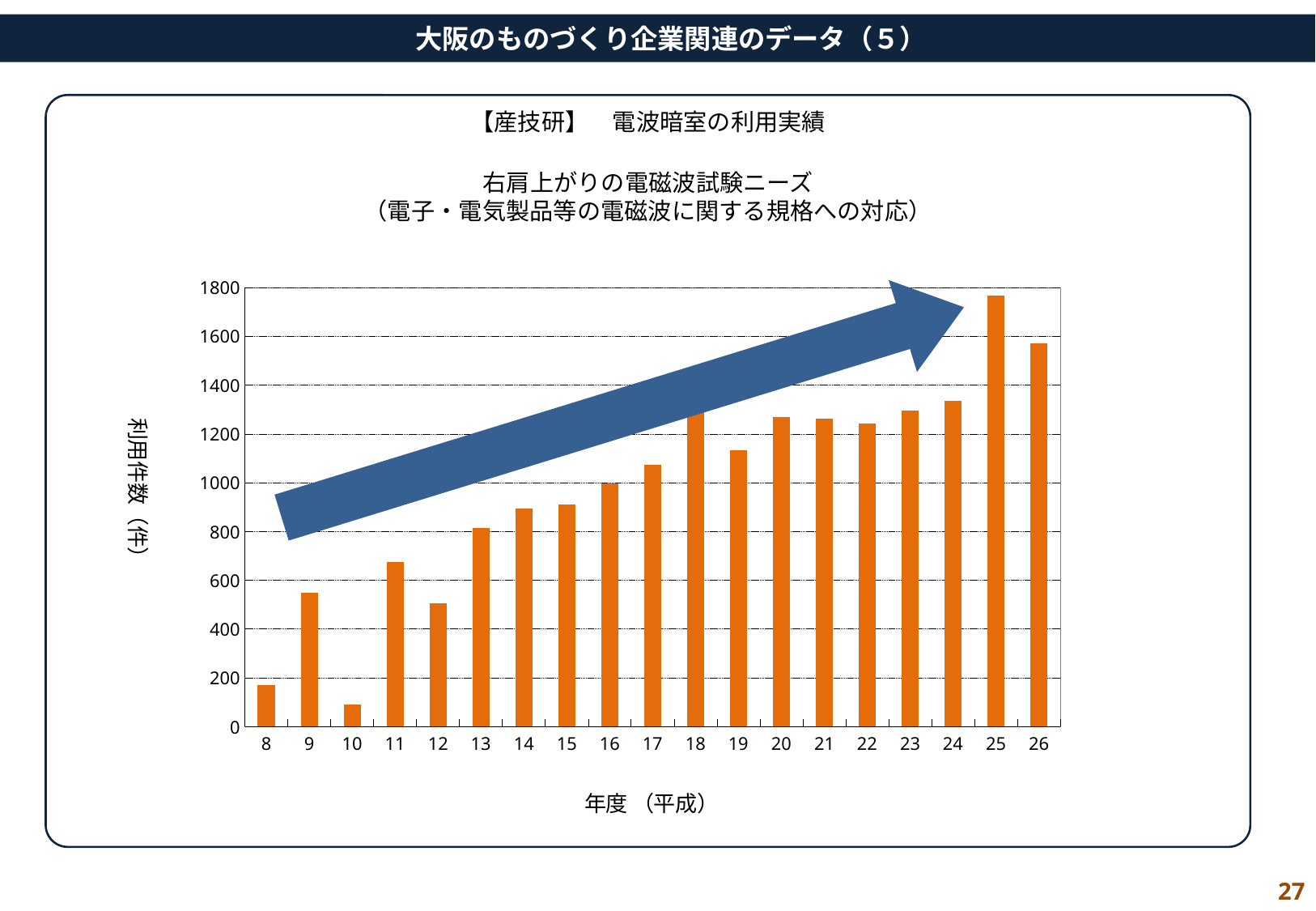
Which year (年度) has the lowest number of uses (利用件数)? 10 Which is larger, the value for year 11 or the value for year 12? year 11 Is the value for year 26 greater or less than 1400? greater Is the value for year 25 greater or less than 1600? greater Is the value for year 8 greater or less than 200? less What is the label of the y axis? 利用件数（件） How many years (年度) are plotted on the x axis? 19 Which year (年度) has the highest number of uses (利用件数)? 25 What kind of chart is shown on the slide? bar chart Overall, do the values rise or fall from year 8 to year 26? rise